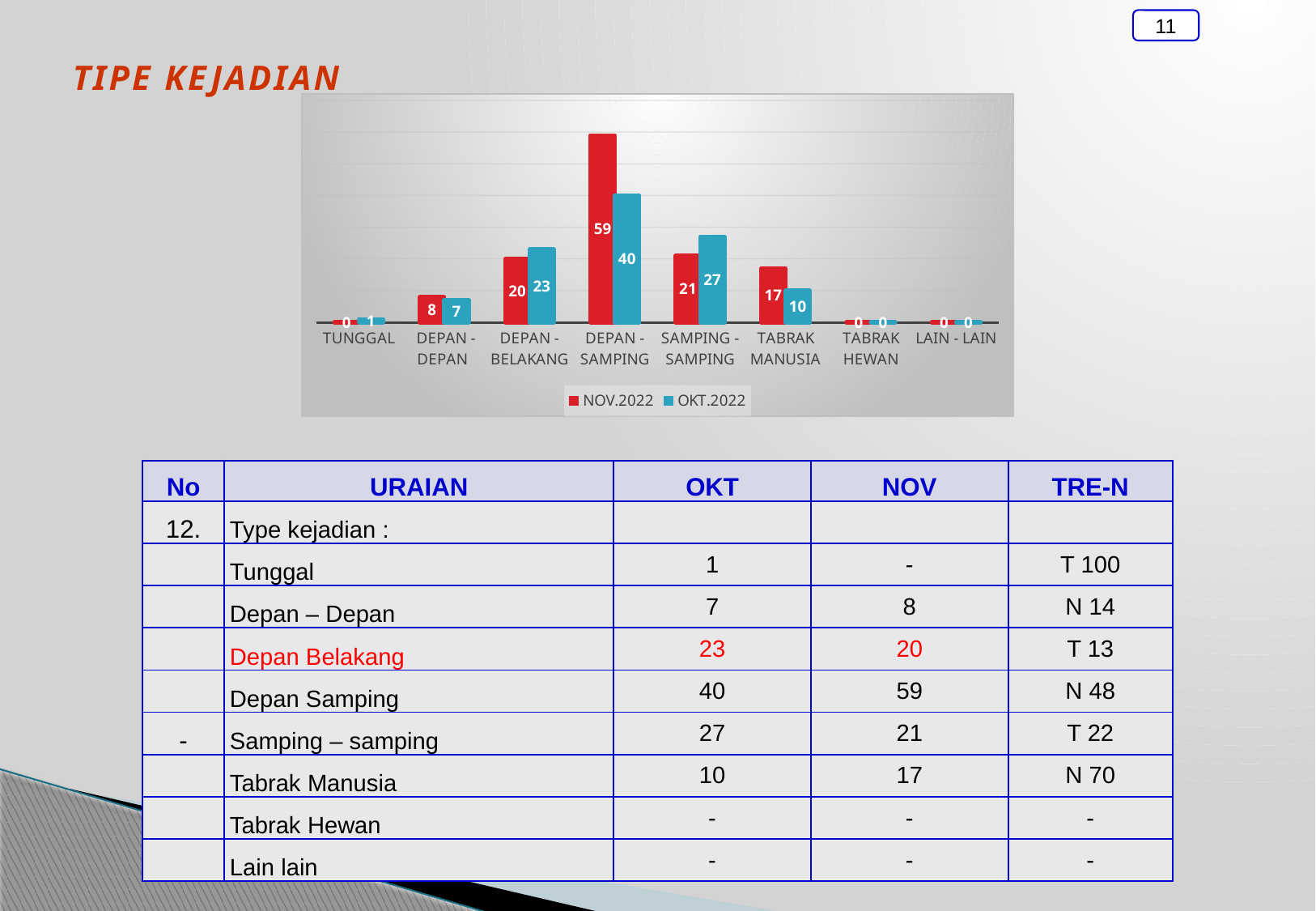
How many categories are shown on the x axis of the chart? 8 What is the difference between the NOV.2022 and OKT.2022 values for DEPAN - SAMPING? 19 For DEPAN - BELAKANG, which series has the larger value, NOV.2022 or OKT.2022? OKT.2022 What is the OKT.2022 value for TUNGGAL? 1 Which series is shown in red in the chart? NOV.2022 What is the difference between the NOV.2022 and OKT.2022 values for TABRAK MANUSIA? 7 Which category has the highest NOV.2022 value? DEPAN - SAMPING What is the OKT.2022 value for SAMPING - SAMPING? 27 Which category has the highest OKT.2022 value? DEPAN - SAMPING How many series does the chart legend list? 2 What is the NOV.2022 value for DEPAN - SAMPING? 59 What kind of chart is shown on the slide? bar chart